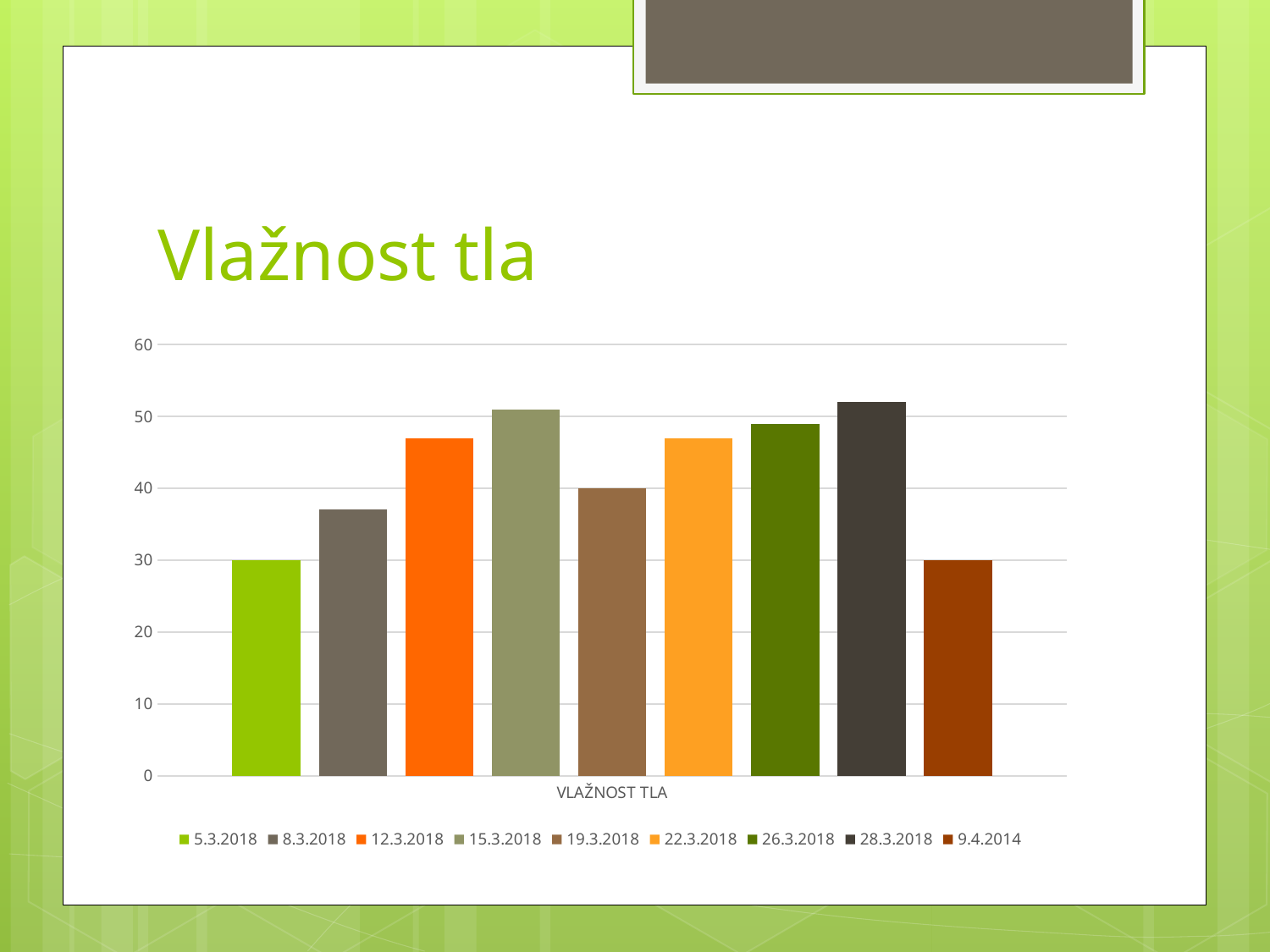
What label is shown on the x axis below the bars? VLAŽNOST TLA Is the value for 15.3.2018 greater or less than 50? greater Is the value for 8.3.2018 greater or less than 40? less How many series does the legend list? 9 Which date has the highest value? 28.3.2018 What is the value for 19.3.2018? 40 What is the title of the chart? Vlažnost tla What type of chart is shown on the slide? bar chart What is the value for 9.4.2014? 30 What is the value for 5.3.2018? 30 What is the difference between the values for 19.3.2018 and 5.3.2018? 10 Which is larger, the value for 15.3.2018 or the value for 19.3.2018? 15.3.2018